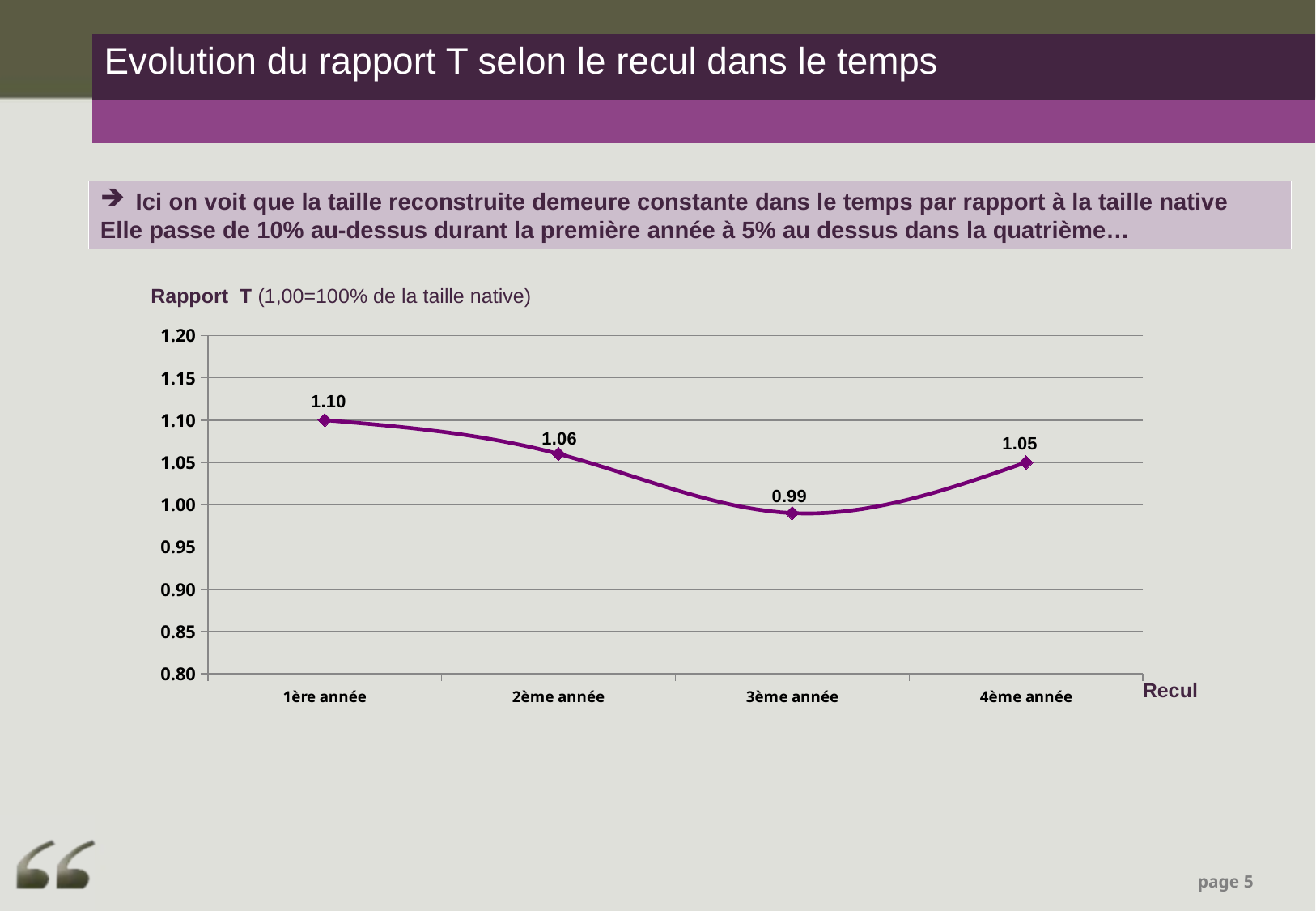
Which year has the highest Rapport T value? 1ère année What is the Rapport T value for 1ère année? 1.10 What is the label of the x axis? Recul Which year has the lowest Rapport T value? 3ème année Is the Rapport T value for 3ème année greater or less than 1.00? less What is the Rapport T value for 3ème année? 0.99 What kind of chart is shown on the slide? line chart What is the difference between the Rapport T values for 2ème année and 3ème année? 0.07 What is the Rapport T value for 4ème année? 1.05 What is the difference between the Rapport T values for 1ère année and 4ème année? 0.05 How many years (data points) are plotted on the chart? 4 Which is larger, the Rapport T value for 2ème année or for 4ème année? 2ème année